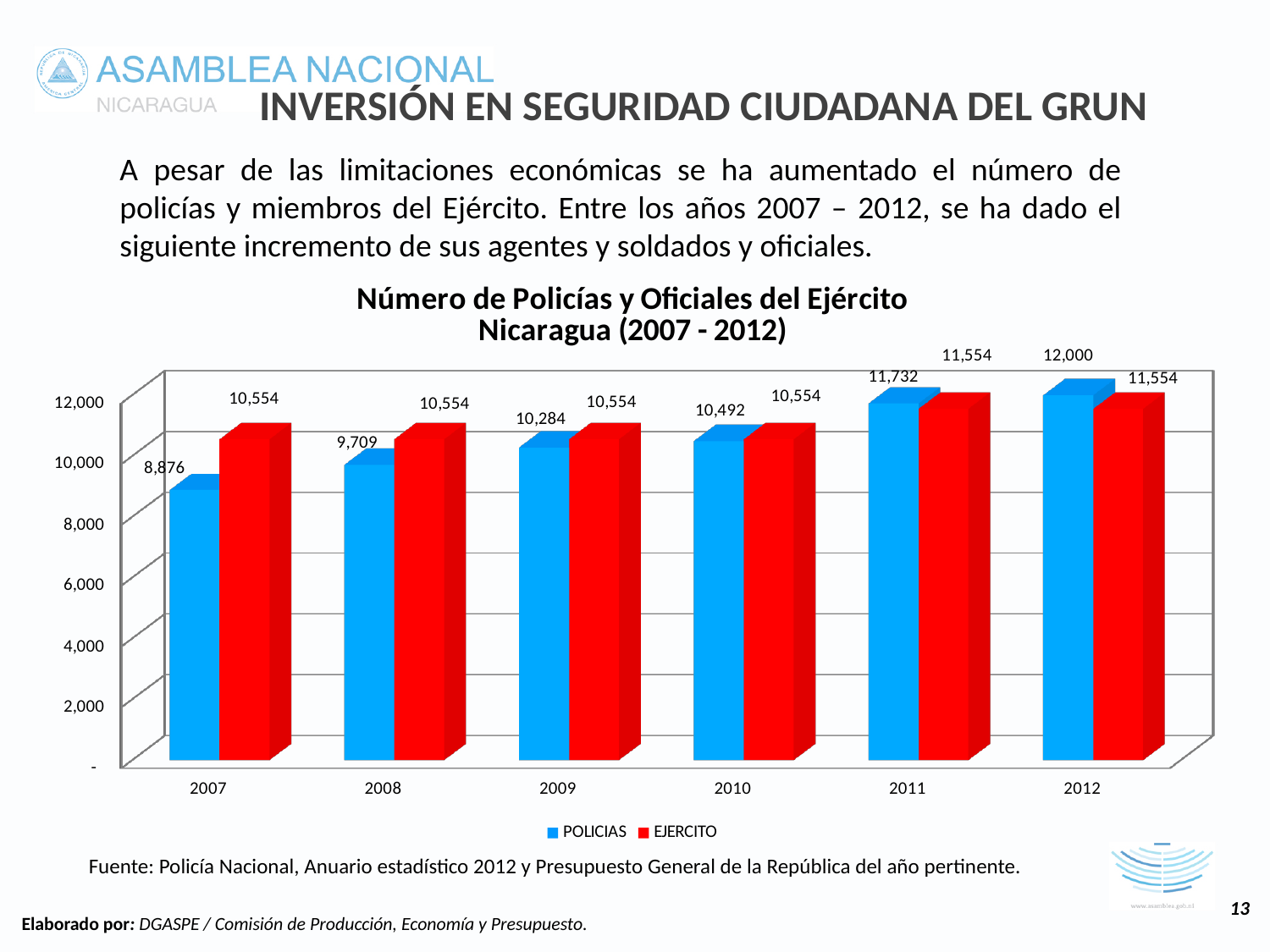
How many years are shown on the x axis? 6 What kind of chart is shown? Bar chart How many series does the legend list? 2 Is the value for POLICIAS in 2009 greater or less than 10,000? greater What is the value for POLICIAS in 2007? 8,876 What is the difference between the POLICIAS values for 2012 and 2007? 3,124 What is the value for POLICIAS in 2012? 12,000 Which is larger in 2010, POLICIAS or EJERCITO? EJERCITO Do the POLICIAS values rise or fall from 2007 to 2012? Rise What is the value for EJERCITO in 2011? 11,554 In which year is the POLICIAS value lowest? 2007 In which year is the POLICIAS value highest? 2012